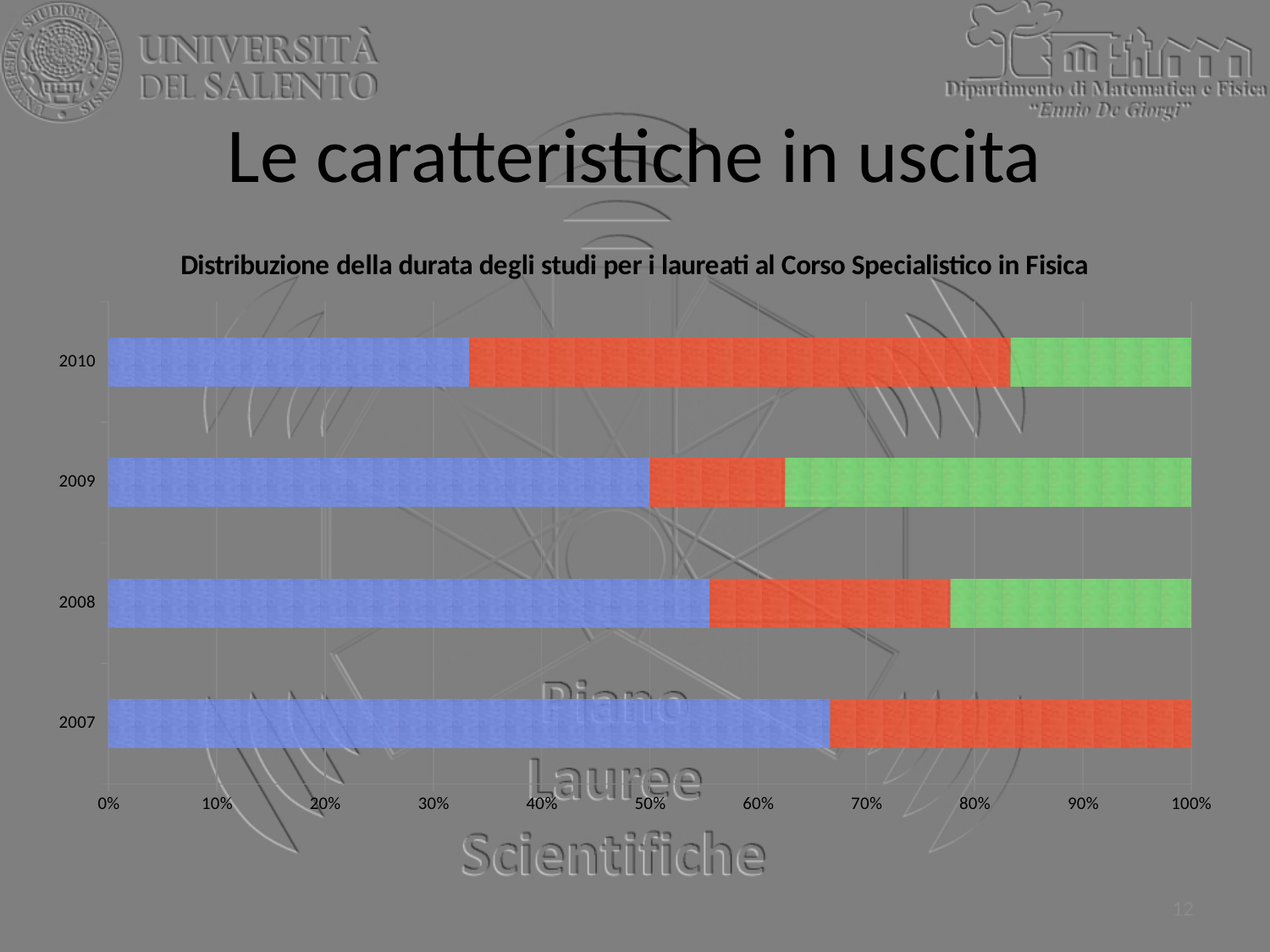
Is the green segment for 2009 larger than the green segment for 2010? Yes, 2009 Does the blue segment rise or fall from 2007 to 2010? Falls What is the title of the chart? Distribuzione della durata degli studi per i laureati al Corso Specialistico in Fisica Which year has the largest blue segment? 2007 Which year has no green segment in its bar? 2007 Which year has the smallest blue segment? 2010 What is the total of the stacked bar for 2009? 100% What kind of chart is shown on the slide? Stacked bar chart Is the blue segment for 2010 greater or less than 40%? less How many years are shown on the vertical axis of the chart? 4 How many coloured segments (series) make up the bars in the chart? 3 Is the blue segment for 2007 greater or less than 60%? greater